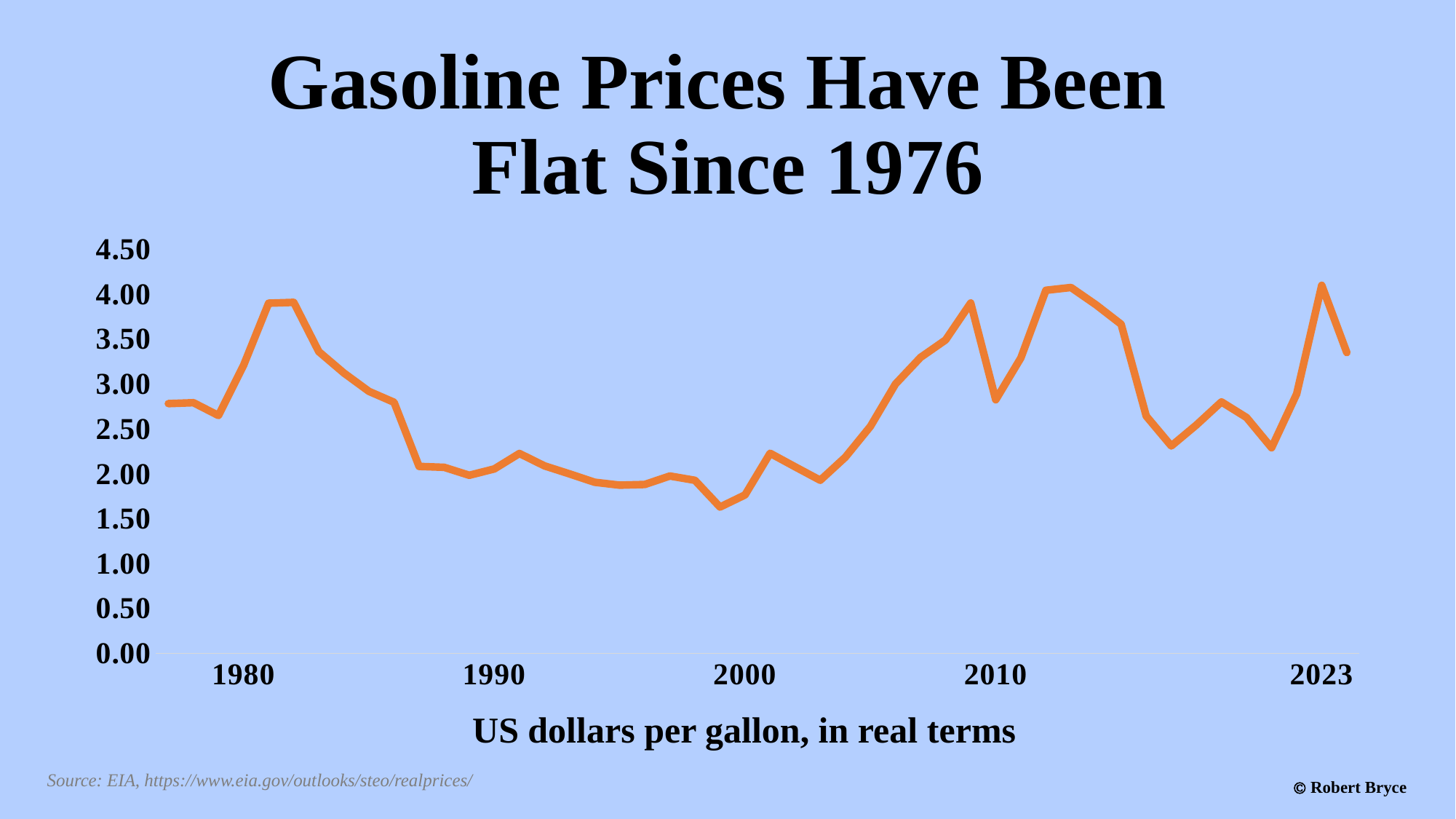
Is the value for 2000 greater or less than 2.00? less Do the values generally rise or fall between 1980 and 1990? fall How many lines (data series) are plotted on the chart? 1 Do the values generally rise or fall between 2000 and 2010? rise Is the value for 2023 greater or less than 3.50? greater Is the value for 2010 greater or less than 2.50? greater Which is larger, the value for 2000 or the value for 2023? 2023 What is the title of the chart? Gasoline Prices Have Been Flat Since 1976 What unit is the chart's data measured in, according to the axis label below the chart? US dollars per gallon, in real terms What kind of chart is shown on the slide? line chart